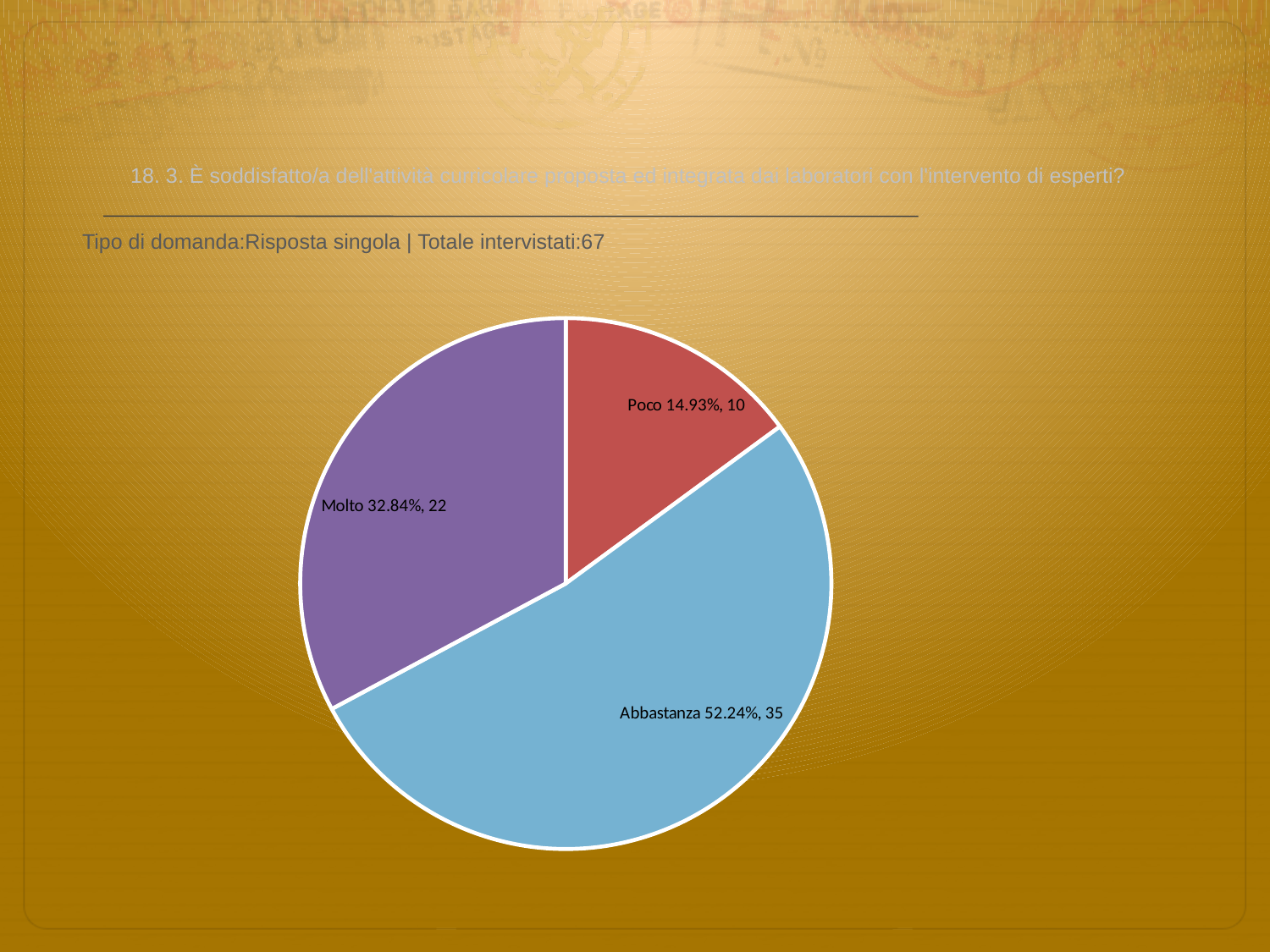
How many respondents answered Poco? 10 What is the difference in respondent count between Abbastanza and Molto? 13 How many slices does the pie chart have? 3 Which is larger, the Molto slice or the Poco slice? Molto What percentage share does the Poco slice have? 14.93% Which category has the largest slice? Abbastanza What kind of chart is shown on the slide? pie chart How many respondents answered Abbastanza? 35 What percentage share does the Molto slice have? 32.84% Which category has the smallest slice? Poco How many respondents answered Molto? 22 What percentage share does the Abbastanza slice have? 52.24%